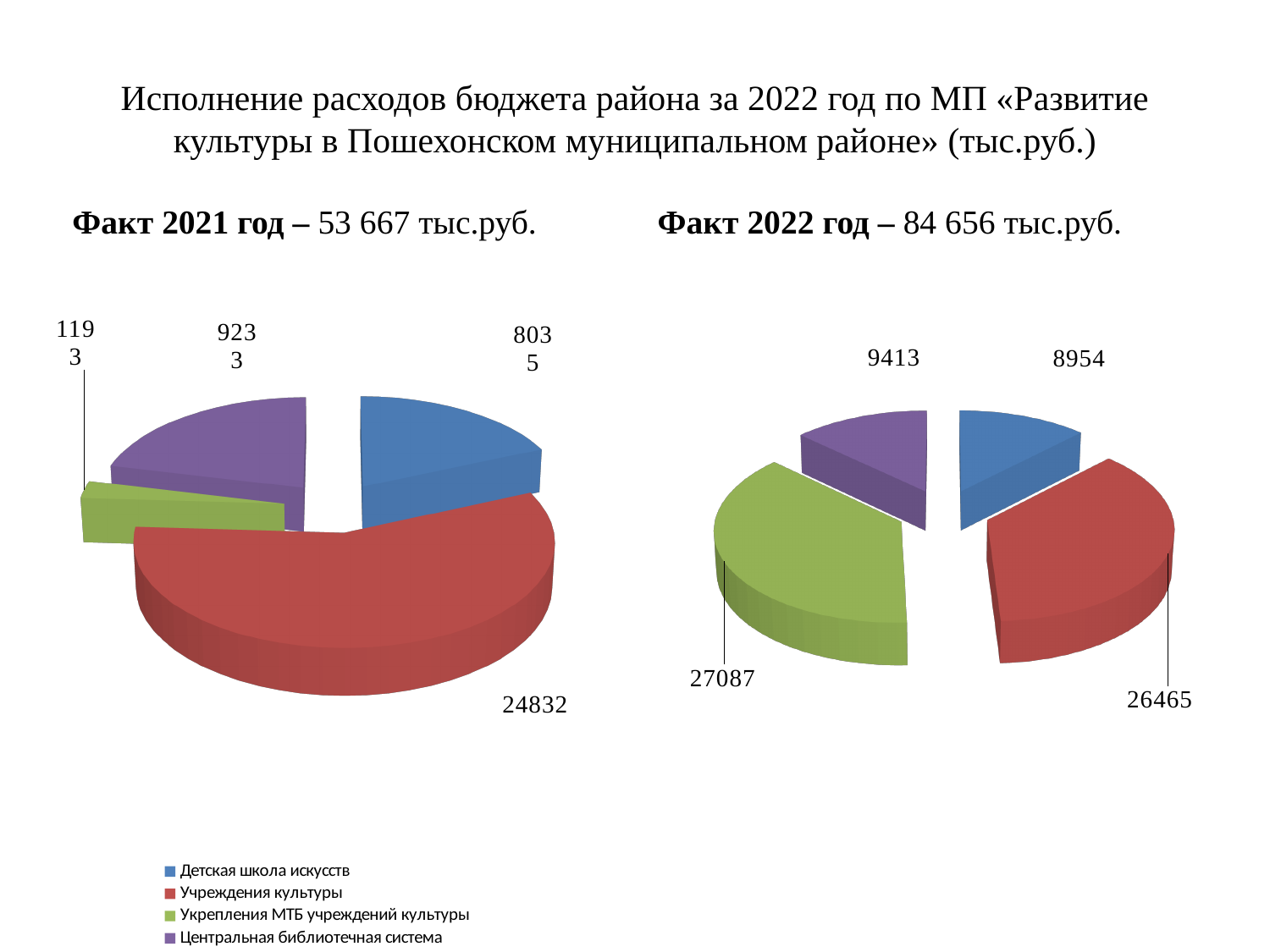
How many categories does the legend list? 4 Which colour represents Учреждения культуры in the charts? Red In the 2021 chart (left), which category has the smallest slice? Укрепления МТБ учреждений культуры In the 2022 chart (right), what is the value for Учреждения культуры? 26465 In the 2022 chart (right), what is the value for Центральная библиотечная система? 9413 What kind of chart is used on this slide for the 2021 and 2022 data? Pie chart In the 2022 chart (right), what is the difference between Укрепления МТБ учреждений культуры and Учреждения культуры? 622 In the 2022 chart (right), what is the value for Укрепления МТБ учреждений культуры? 27087 In the 2021 chart (left), what is the value for Учреждения культуры? 24832 In the 2022 chart (right), which category has the smallest value? Детская школа искусств In the 2021 chart (left), which category has the largest slice? Учреждения культуры In the 2022 chart (right), what is the value for Детская школа искусств? 8954